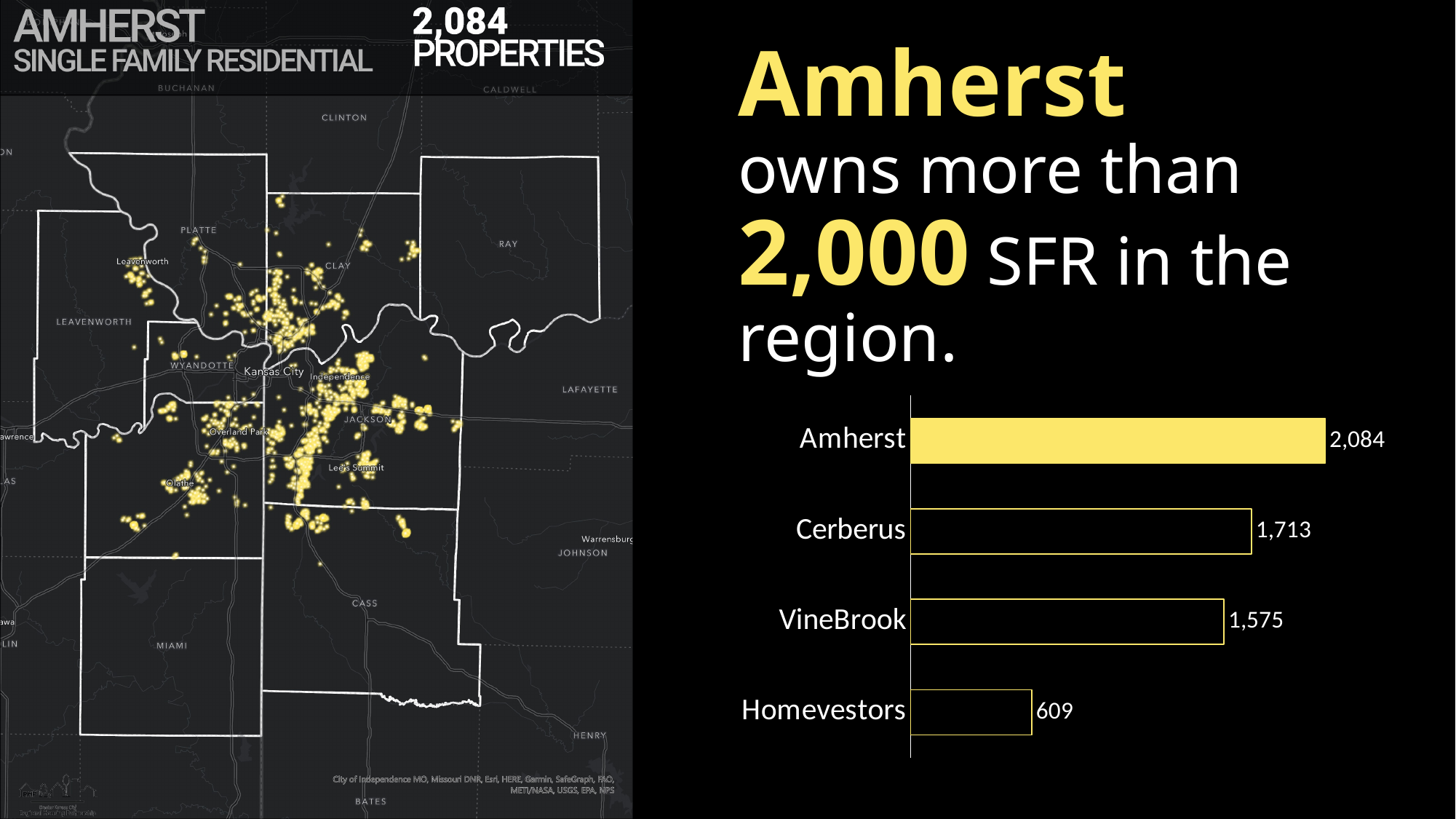
How many owners are shown in the bar chart? 4 In the bar chart, what is the difference between the values for Amherst and Cerberus? 371 In the bar chart, what is the value for Cerberus? 1,713 In the bar chart, how many properties does Amherst own? 2,084 In the bar chart, what is the difference between the values for VineBrook and Homevestors? 966 In the bar chart, what is the value for VineBrook? 1,575 In the bar chart, which bar is filled in solid yellow? Amherst In the bar chart, which is larger, the value for Cerberus or the value for VineBrook? Cerberus In the bar chart, which owner has the lowest value? Homevestors In the bar chart, which owner has the highest value? Amherst What kind of chart is shown on the right side of the slide? Bar chart In the bar chart, what is the value for Homevestors? 609